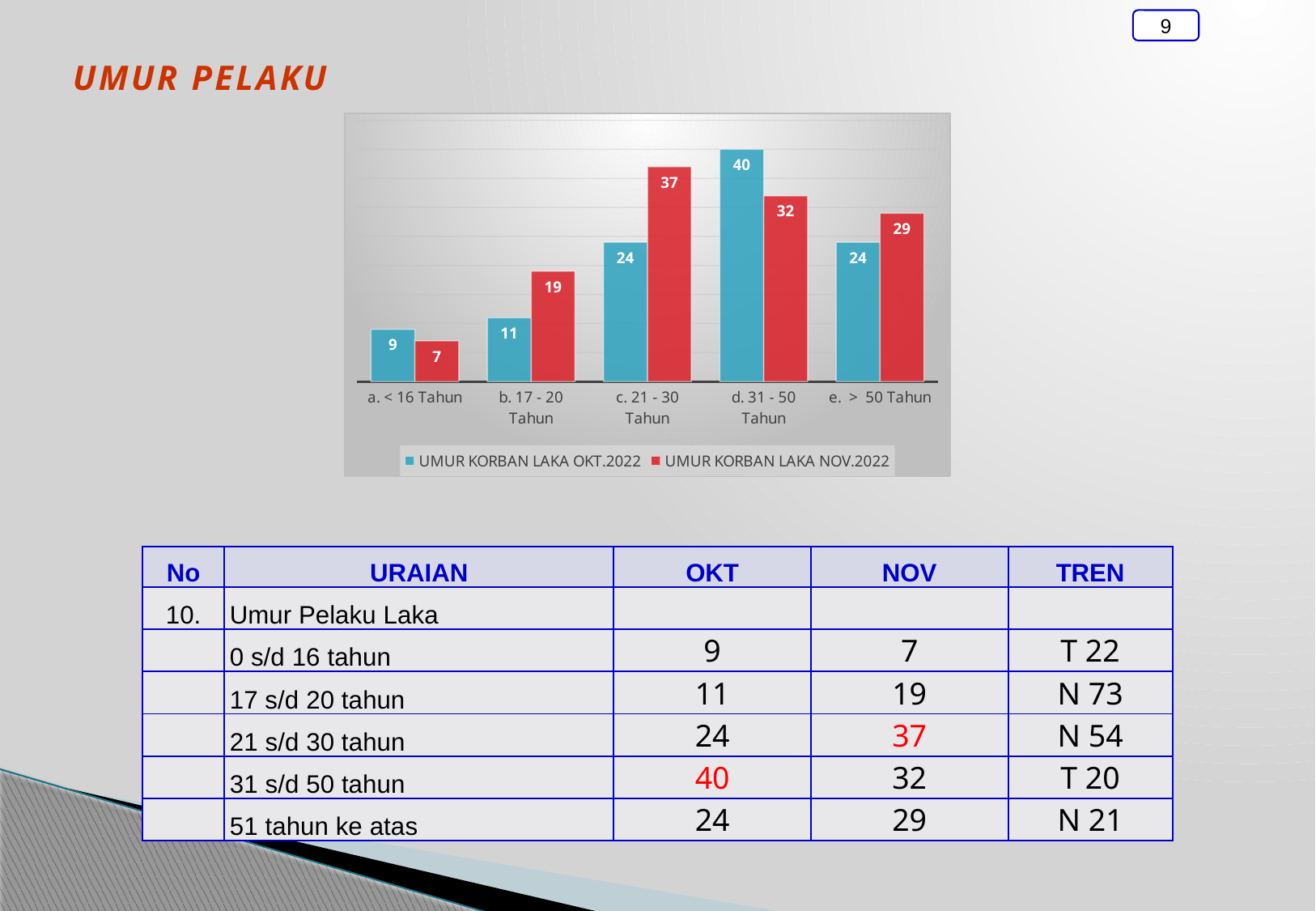
What is the value for UMUR KORBAN LAKA OKT.2022 in the category d. 31 - 50 Tahun? 40 Which category has the lowest value for UMUR KORBAN LAKA NOV.2022? a. < 16 Tahun What is the difference between the OKT.2022 and NOV.2022 values for d. 31 - 50 Tahun? 8 What kind of chart is shown on the slide? Bar chart Which category has the highest value for UMUR KORBAN LAKA OKT.2022? d. 31 - 50 Tahun What is the value for UMUR KORBAN LAKA NOV.2022 in the category c. 21 - 30 Tahun? 37 Which colour represents UMUR KORBAN LAKA NOV.2022 in the chart? Red What is the value for UMUR KORBAN LAKA NOV.2022 in the category a. < 16 Tahun? 7 What is the difference between the OKT.2022 and NOV.2022 values for b. 17 - 20 Tahun? 8 How many series does the chart legend list? 2 How many age categories are shown on the x axis of the chart? 5 Which is larger for e. > 50 Tahun: the OKT.2022 value or the NOV.2022 value? NOV.2022